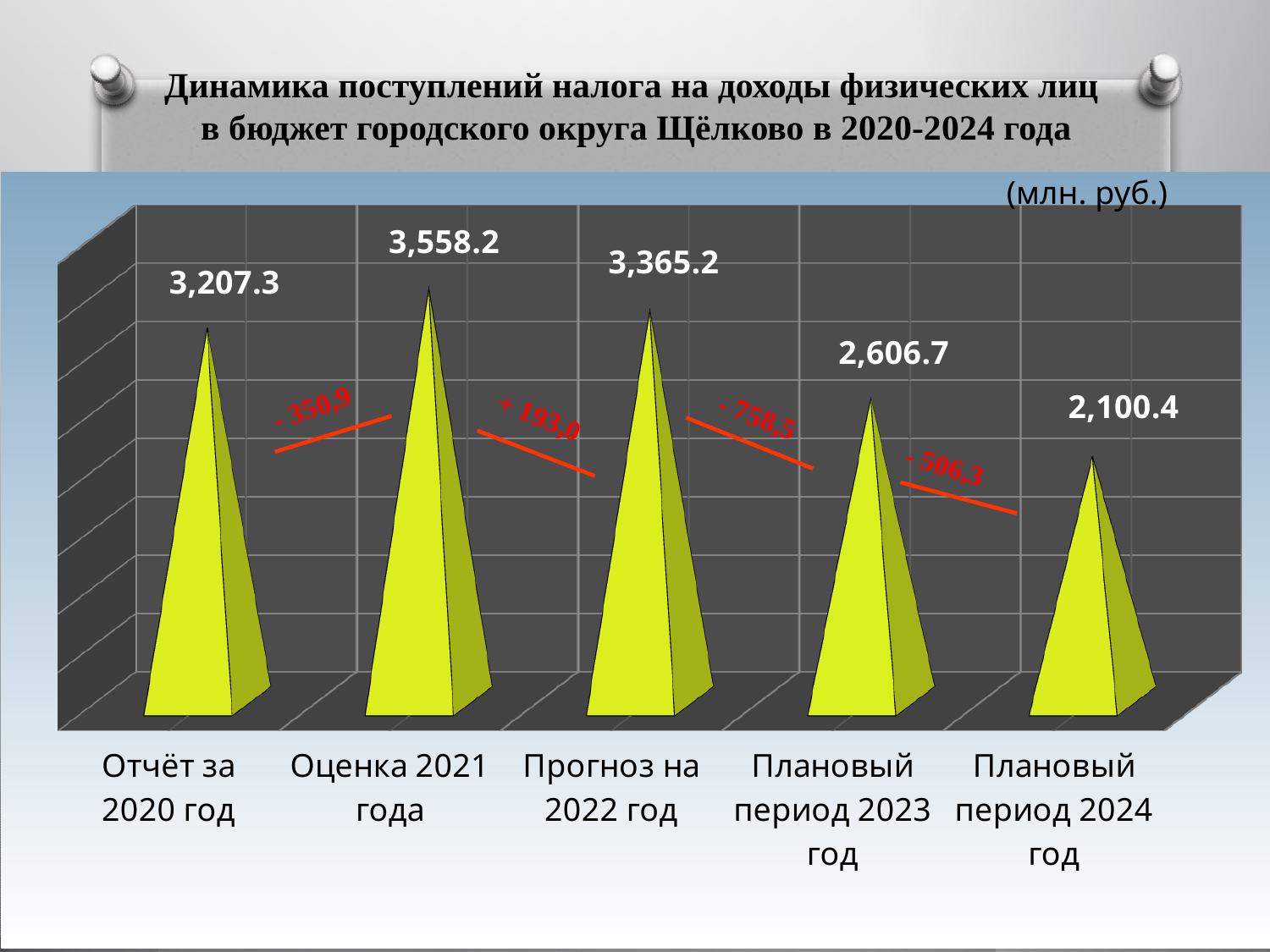
What is the value for Прогноз на 2022 год? 3,365.2 What is the value for Отчёт за 2020 год? 3,207.3 Which category has the lowest value? Плановый период 2024 год What is the value for Оценка 2021 года? 3,558.2 What is the value for Плановый период 2024 год? 2,100.4 Which is larger, the value for Отчёт за 2020 год or the value for Прогноз на 2022 год? Прогноз на 2022 год What unit of measurement is indicated for the chart values? млн. руб. Which category has the highest value? Оценка 2021 года How many categories are shown in the chart? 5 What is the difference between the values for Прогноз на 2022 год and Плановый период 2023 год? 758.5 What is the difference between the values for Плановый период 2023 год and Плановый период 2024 год? 506.3 What kind of chart is shown on the slide? Bar chart